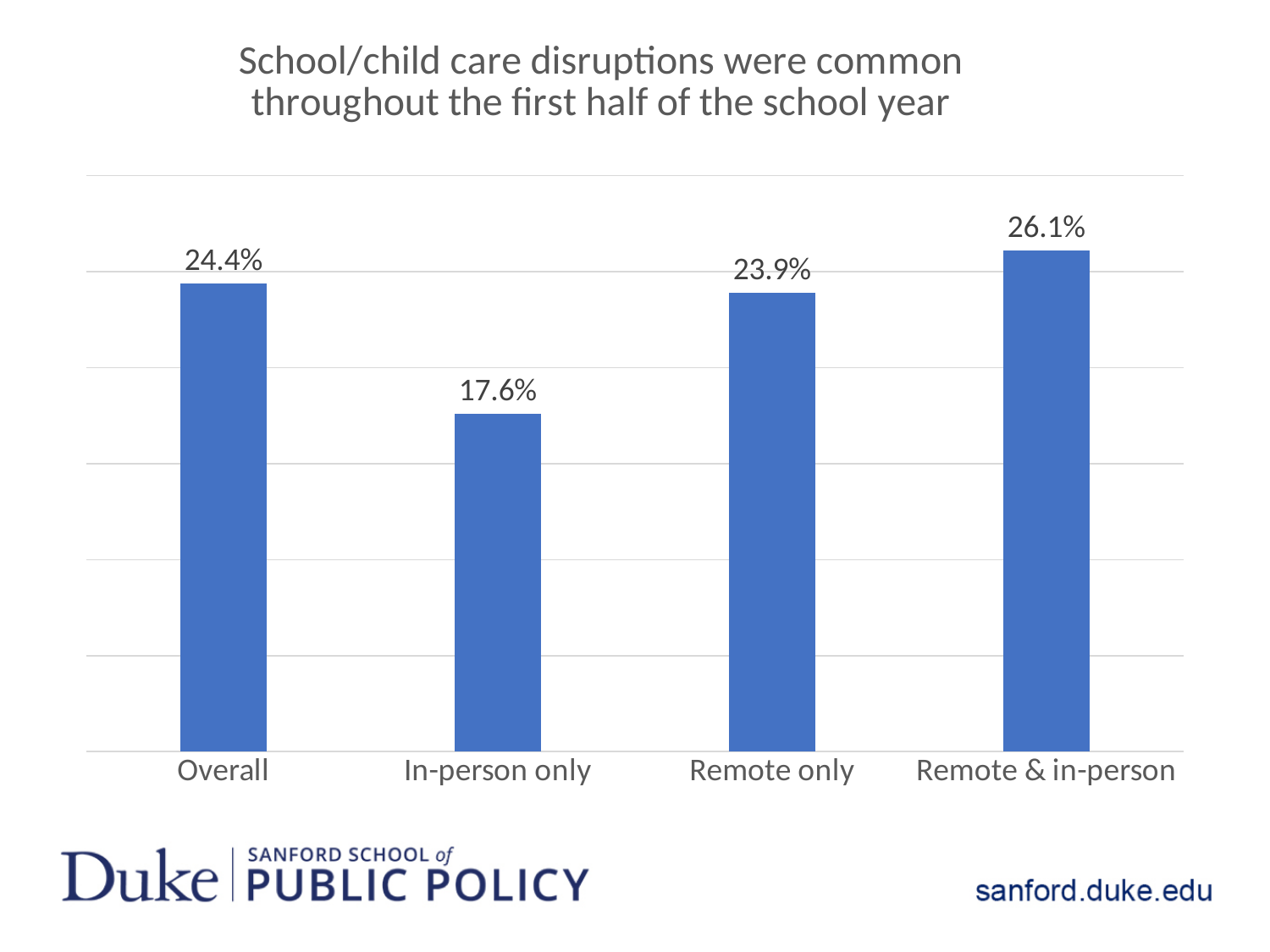
Which category has the lowest value? In-person only What is the difference between the values for Overall and Remote only? 0.5% How many categories are shown on the x axis? 4 Which is larger, the value for In-person only or the value for Remote only? Remote only What is the value for Remote only? 23.9% What is the value for In-person only? 17.6% What is the value for Remote & in-person? 26.1% Which category has the highest value? Remote & in-person What is the difference between the values for Remote & in-person and In-person only? 8.5% What is the value for Overall? 24.4% What is the title of the chart? School/child care disruptions were common throughout the first half of the school year What kind of chart is shown on the slide? Bar chart